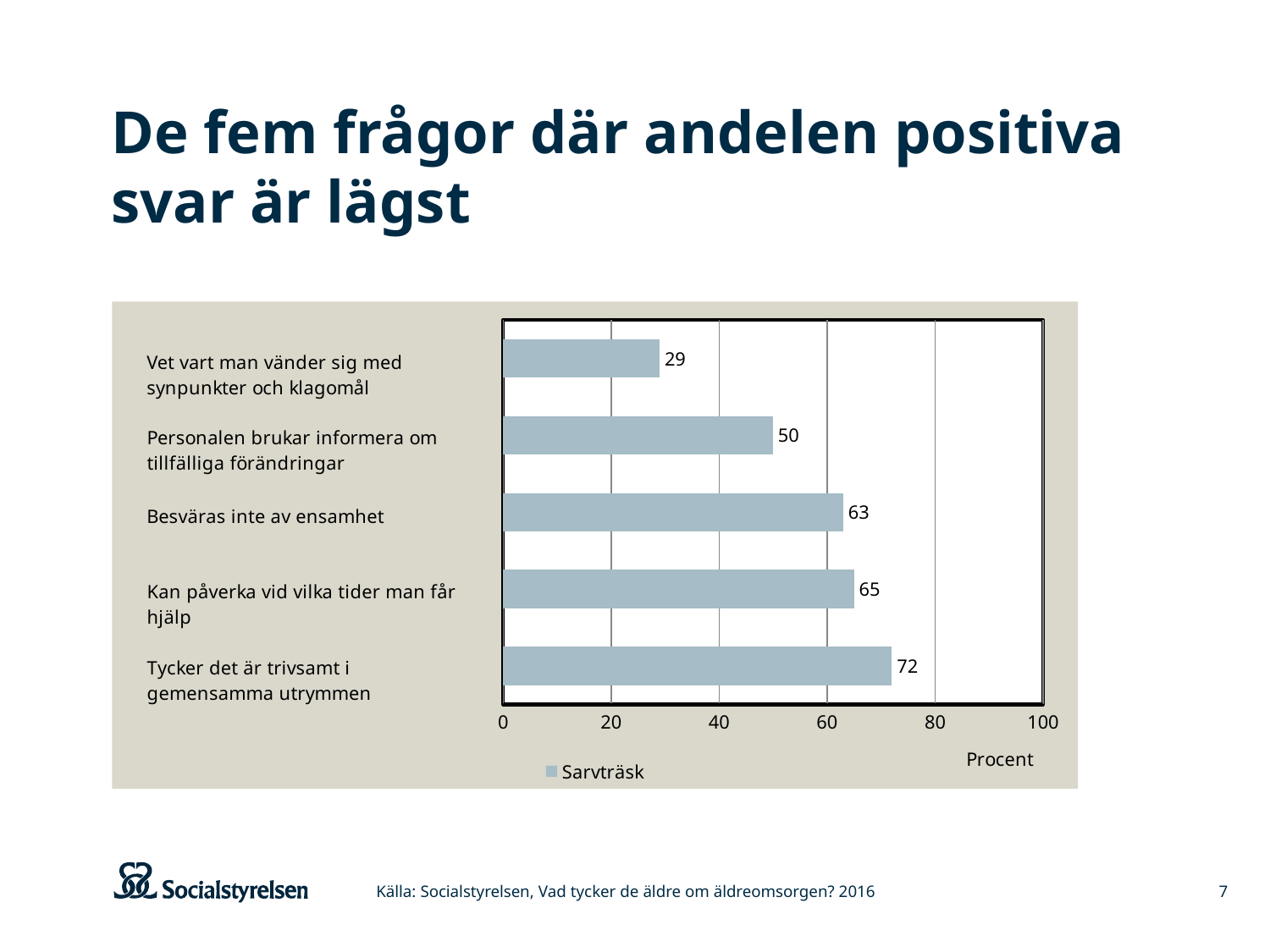
What is the value for "Vet vart man vänder sig med synpunkter och klagomål"? 29 What is the name of the series shown in the legend? Sarvträsk Which category has the highest value? Tycker det är trivsamt i gemensamma utrymmen What is the difference between the values for "Tycker det är trivsamt i gemensamma utrymmen" and "Personalen brukar informera om tillfälliga förändringar"? 22 How many series does the legend list? 1 How many categories are shown in the chart? 5 What is the value for "Besväras inte av ensamhet"? 63 Which is larger: the value for "Kan påverka vid vilka tider man får hjälp" or for "Besväras inte av ensamhet"? Kan påverka vid vilka tider man får hjälp What is the value for "Tycker det är trivsamt i gemensamma utrymmen"? 72 What kind of chart is shown on the slide? bar chart Which category has the lowest value? Vet vart man vänder sig med synpunkter och klagomål Is the value for "Personalen brukar informera om tillfälliga förändringar" greater or less than 40? greater